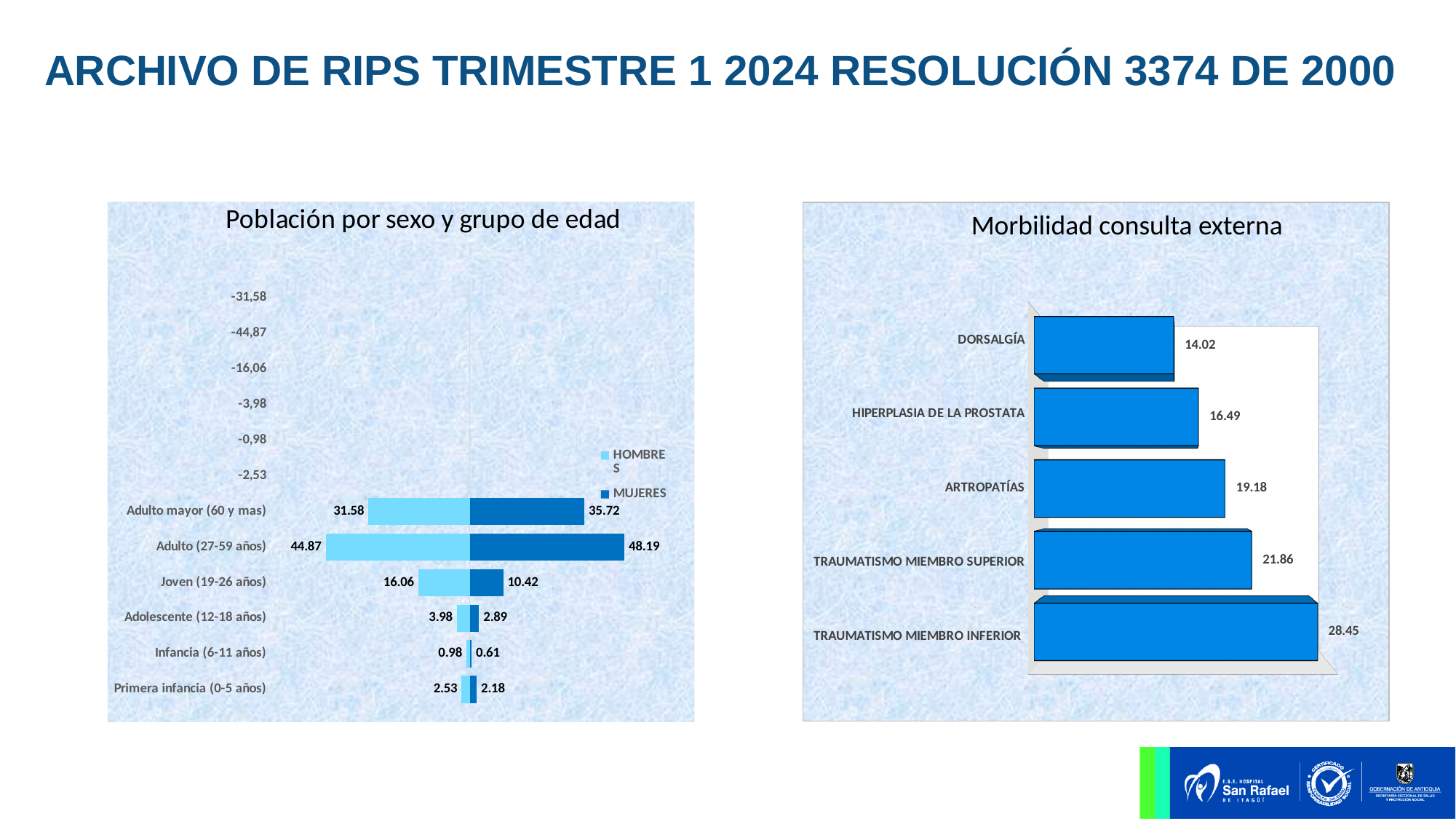
In the 'Morbilidad consulta externa' chart, what is the difference between TRAUMATISMO MIEMBRO INFERIOR and TRAUMATISMO MIEMBRO SUPERIOR? 6.59 In the 'Población por sexo y grupo de edad' chart, what is the HOMBRES value for Adulto (27-59 años)? 44.87 In the 'Morbilidad consulta externa' chart, what is the value for DORSALGÍA? 14.02 In the 'Morbilidad consulta externa' chart, which category has the lowest value? DORSALGÍA How many series does the legend of the 'Población por sexo y grupo de edad' chart list? 2 In the 'Población por sexo y grupo de edad' chart, which age group has the lowest HOMBRES value? Infancia (6-11 años) In the 'Población por sexo y grupo de edad' chart, what is the difference between the MUJERES and HOMBRES values for Adulto (27-59 años)? 3.32 In the 'Población por sexo y grupo de edad' chart, which is larger for Adulto mayor (60 y mas): HOMBRES or MUJERES? MUJERES In the 'Población por sexo y grupo de edad' chart, what is the MUJERES value for Joven (19-26 años)? 10.42 In the 'Morbilidad consulta externa' chart, how many categories are shown? 5 In the 'Morbilidad consulta externa' chart, which category has the highest value? TRAUMATISMO MIEMBRO INFERIOR What kind of chart is 'Morbilidad consulta externa'? Bar chart